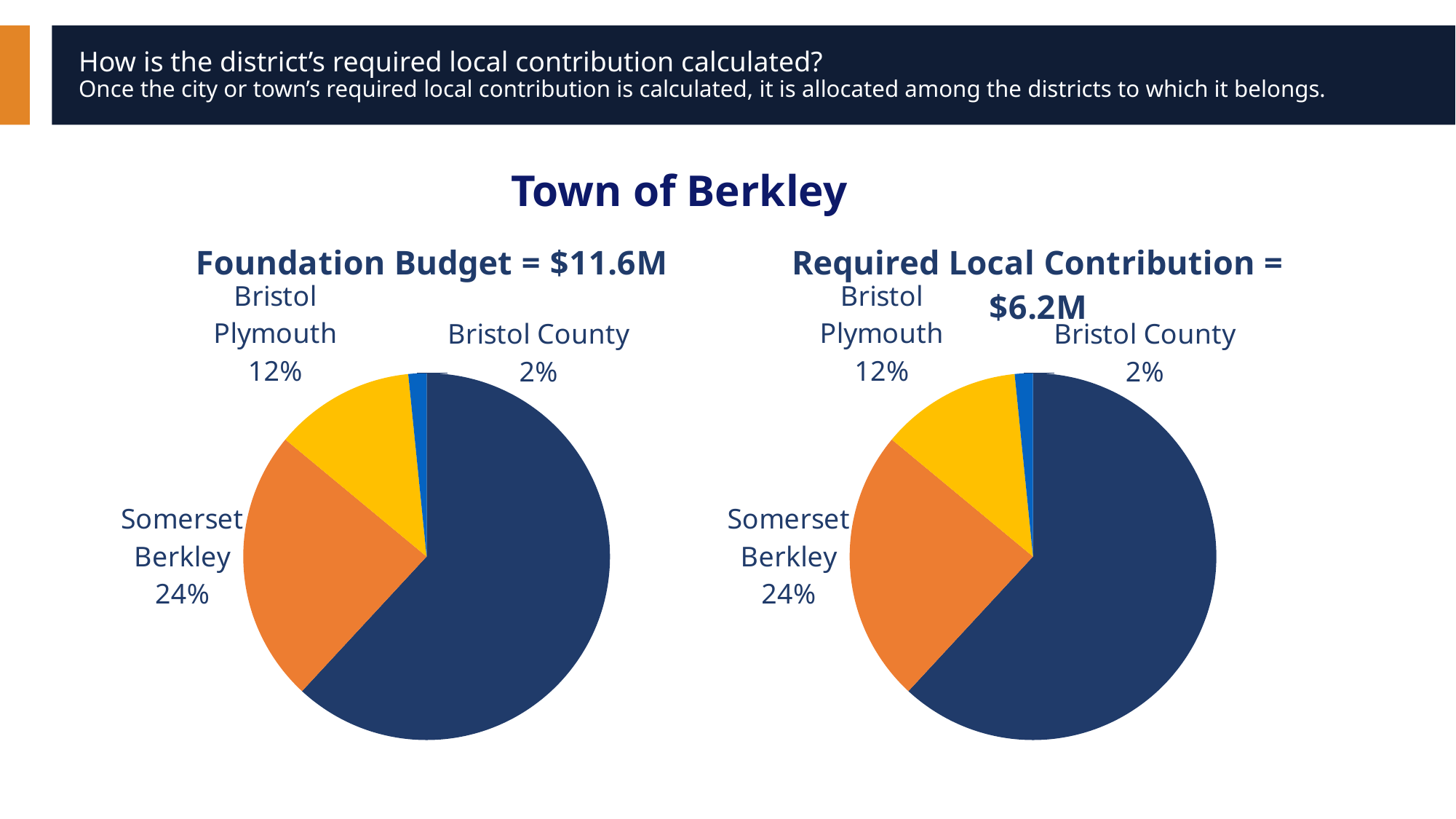
How many slices does the Required Local Contribution = $6.2M pie chart have? 4 In the Required Local Contribution = $6.2M chart, what share does Bristol Plymouth have? 12% In the Foundation Budget = $11.6M chart, what is the difference in percentage points between Somerset Berkley and Bristol Plymouth? 12 What type of chart is used on the left side of the slide? Pie chart In the Required Local Contribution = $6.2M chart, which is larger, Somerset Berkley or Bristol Plymouth? Somerset Berkley In the Required Local Contribution = $6.2M chart, what share does Bristol County have? 2% In the Required Local Contribution = $6.2M chart, what share does Somerset Berkley have? 24% In the Foundation Budget = $11.6M chart, which of the labeled slices is the smallest? Bristol County In the Foundation Budget = $11.6M chart, what share does Bristol County have? 2% In the Foundation Budget = $11.6M chart, what share does Bristol Plymouth have? 12% What is the title of the chart on the left? Foundation Budget = $11.6M In the Foundation Budget = $11.6M chart, what share does Somerset Berkley have? 24%